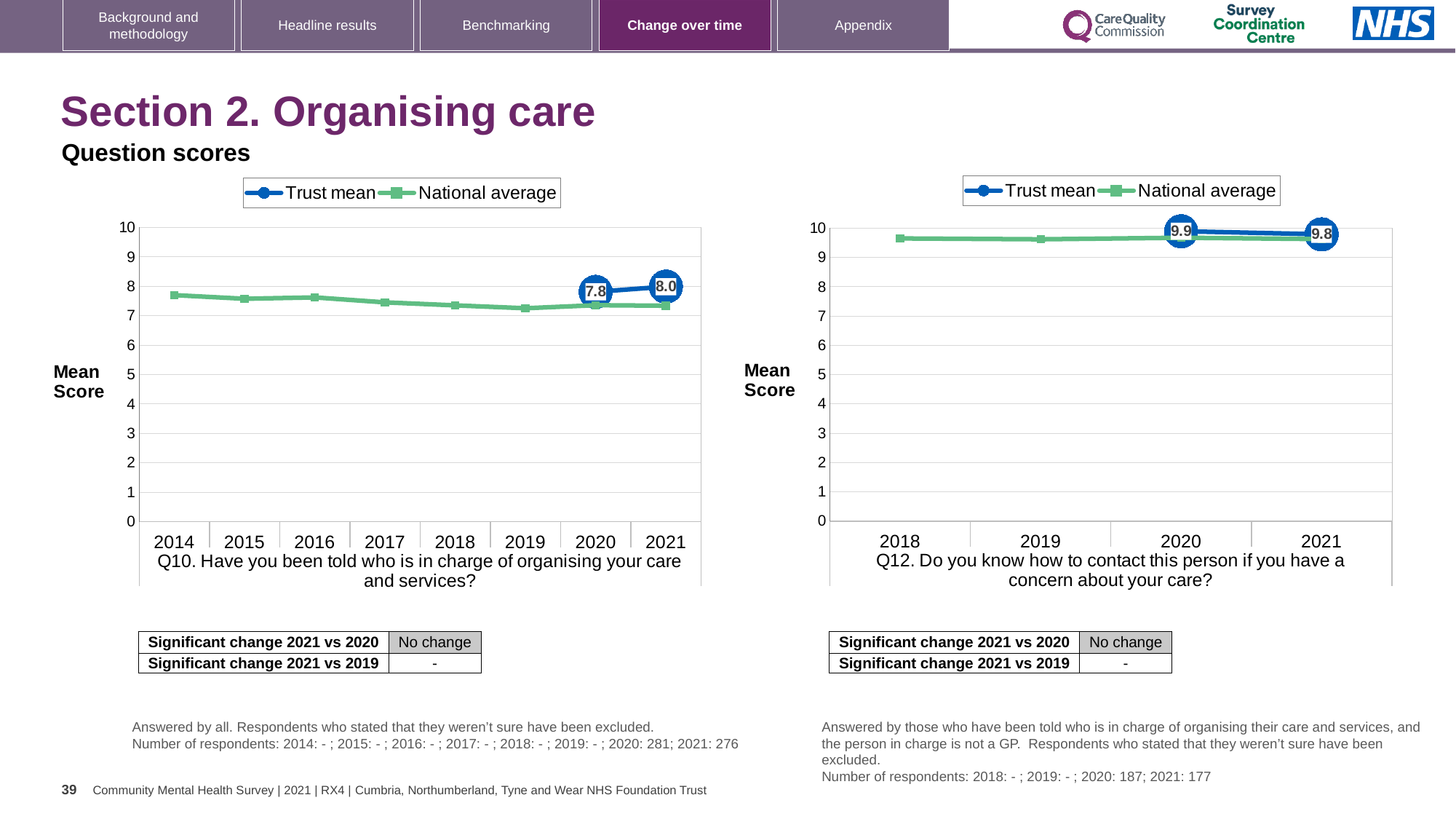
In the Q10 chart on the left, what is the Trust mean for 2020? 7.8 In the Q10 chart on the left, what is the Trust mean for 2021? 8.0 In the Q10 chart on the left, did the Trust mean rise or fall from 2020 to 2021? rise How many years are shown on the x axis of the Q10 chart on the left? 8 In the Q12 chart on the right, is the National average for 2018 greater or less than 9? greater What kind of chart is the Q10 chart on the left? line chart In the Q12 chart on the right, what is the Trust mean for 2020? 9.9 How many series does the legend of the Q12 chart on the right list? 2 In the Q10 chart on the left, is the National average for 2014 greater or less than 7? greater In the Q10 chart on the left, by how much did the Trust mean change from 2020 to 2021? 0.2 In the Q12 chart on the right, what is the Trust mean for 2021? 9.8 In the Q12 chart on the right, did the Trust mean rise or fall from 2020 to 2021? fall